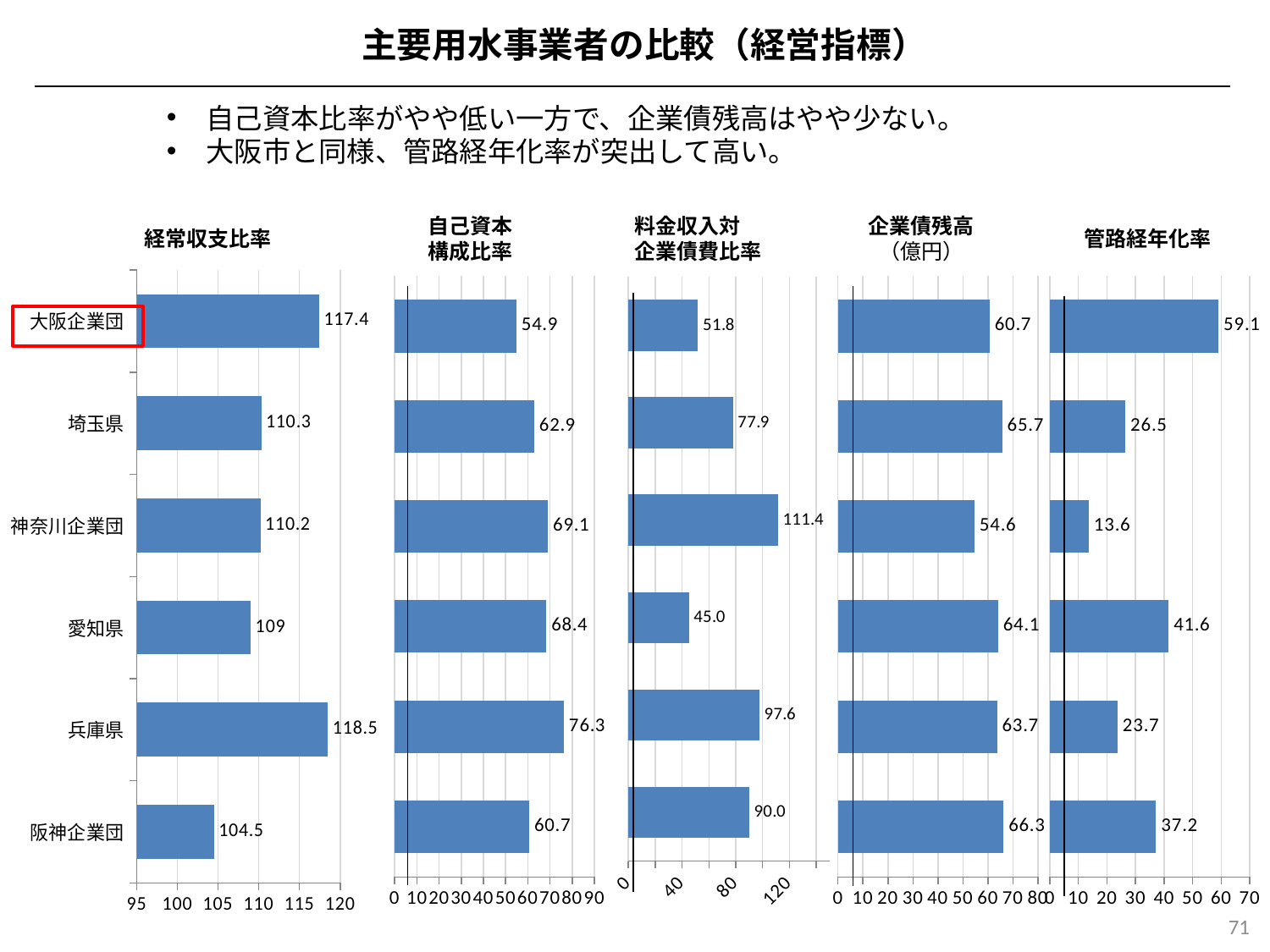
In the 企業債残高（億円） chart, which is larger, 埼玉県 or 神奈川企業団? 埼玉県 In the 管路経年化率 chart, what is the difference between 大阪企業団 and 神奈川企業団? 45.5 In the 経常収支比率 chart, what is the value for 大阪企業団? 117.4 In the 料金収入対企業債費比率 chart, which entity has the lowest value? 愛知県 In the 管路経年化率 chart, is the value for 愛知県 greater or less than 40? greater In the 企業債残高（億円） chart, what is the value for 阪神企業団? 66.3 What kind of chart is the 自己資本構成比率 chart? Bar chart In the 料金収入対企業債費比率 chart, what is the value for 神奈川企業団? 111.4 How many charts are shown on the slide? 5 In the 自己資本構成比率 chart, which entity has the lowest value? 大阪企業団 In the 経常収支比率 chart, which entity has the highest value? 兵庫県 How many entities are compared in the 経常収支比率 chart? 6